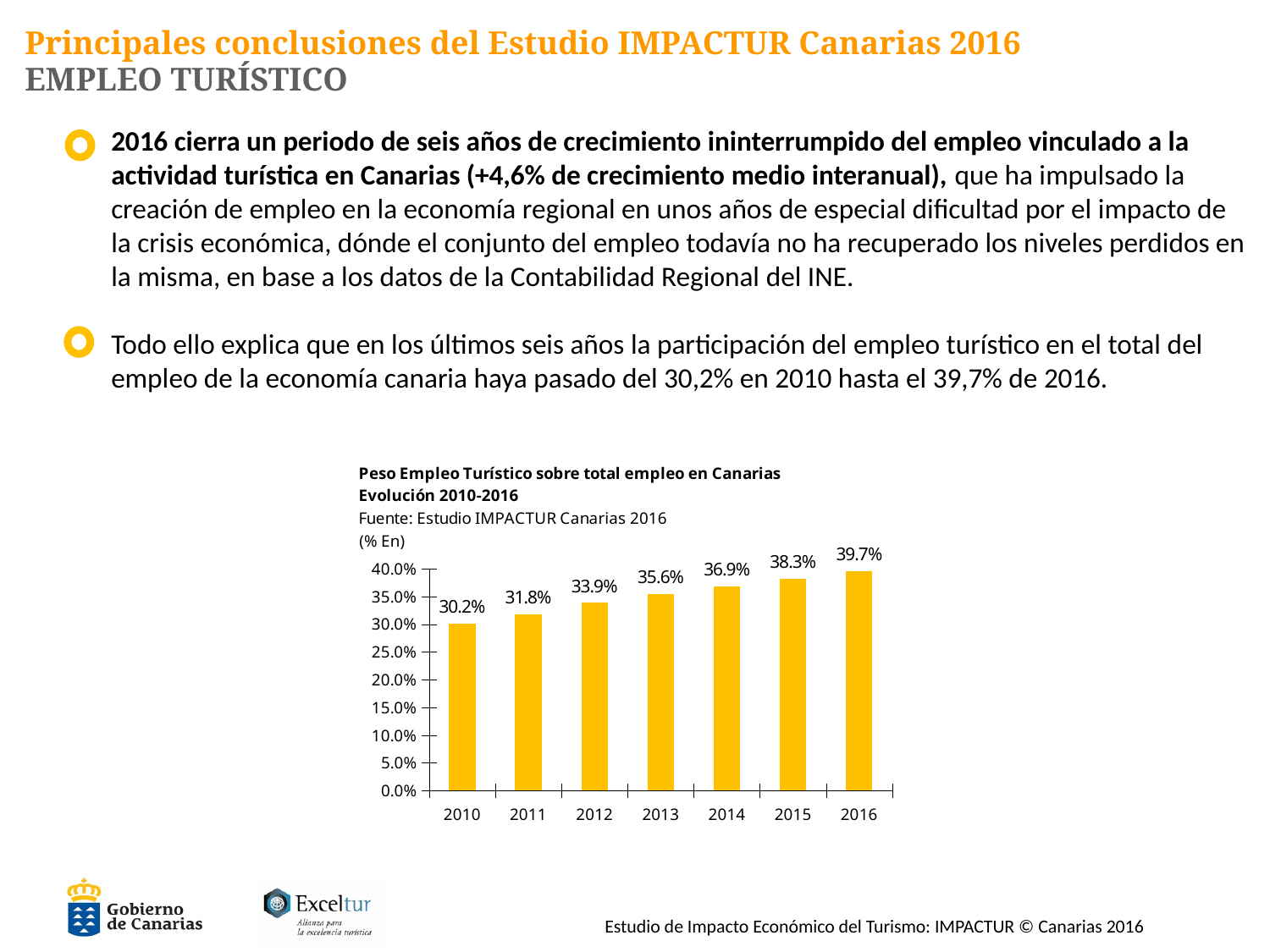
What is the value for 2013? 35.6% What is the difference between the values for 2015 and 2014? 1.4% What is the value for 2010? 30.2% Is the value for 2011 greater or less than 35.0%? less What kind of chart is this? bar chart What is the value for 2016? 39.7% Which year has the highest value? 2016 Which year has the lowest value? 2010 Which is larger, the value for 2012 or the value for 2014? 2014 What is the difference between the values for 2016 and 2010? 9.5% Do the values rise or fall from 2010 to 2016? rise How many years are shown on the x axis? 7